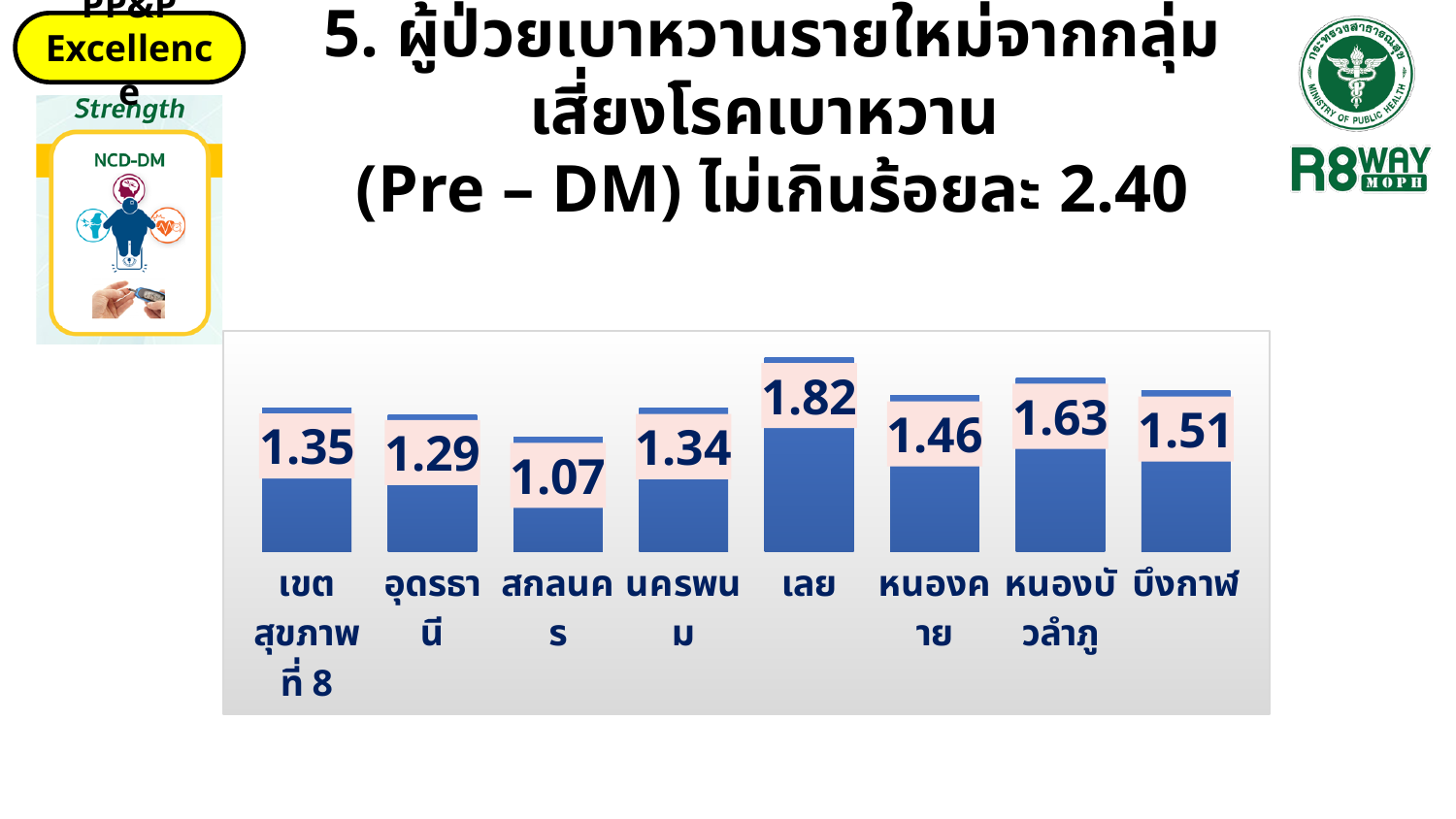
What is the value shown for เลย? 1.82 Which category has the lowest value? สกลนคร What is the difference between the values for หนองบัวลำภู and บึงกาฬ? 0.12 Which category has the highest value? เลย What is the value shown for หนองบัวลำภู? 1.63 What is the difference between the values for เลย and สกลนคร? 0.75 Which has a larger value, หนองคาย or อุดรธานี? หนองคาย What is the value shown for เขตสุขภาพที่ 8? 1.35 What is the value shown for สกลนคร? 1.07 How many categories are shown in the chart? 8 What kind of chart is shown on the slide? bar chart According to the slide title, what is the target threshold (ร้อยละ) for new diabetes patients from the Pre-DM group? 2.40